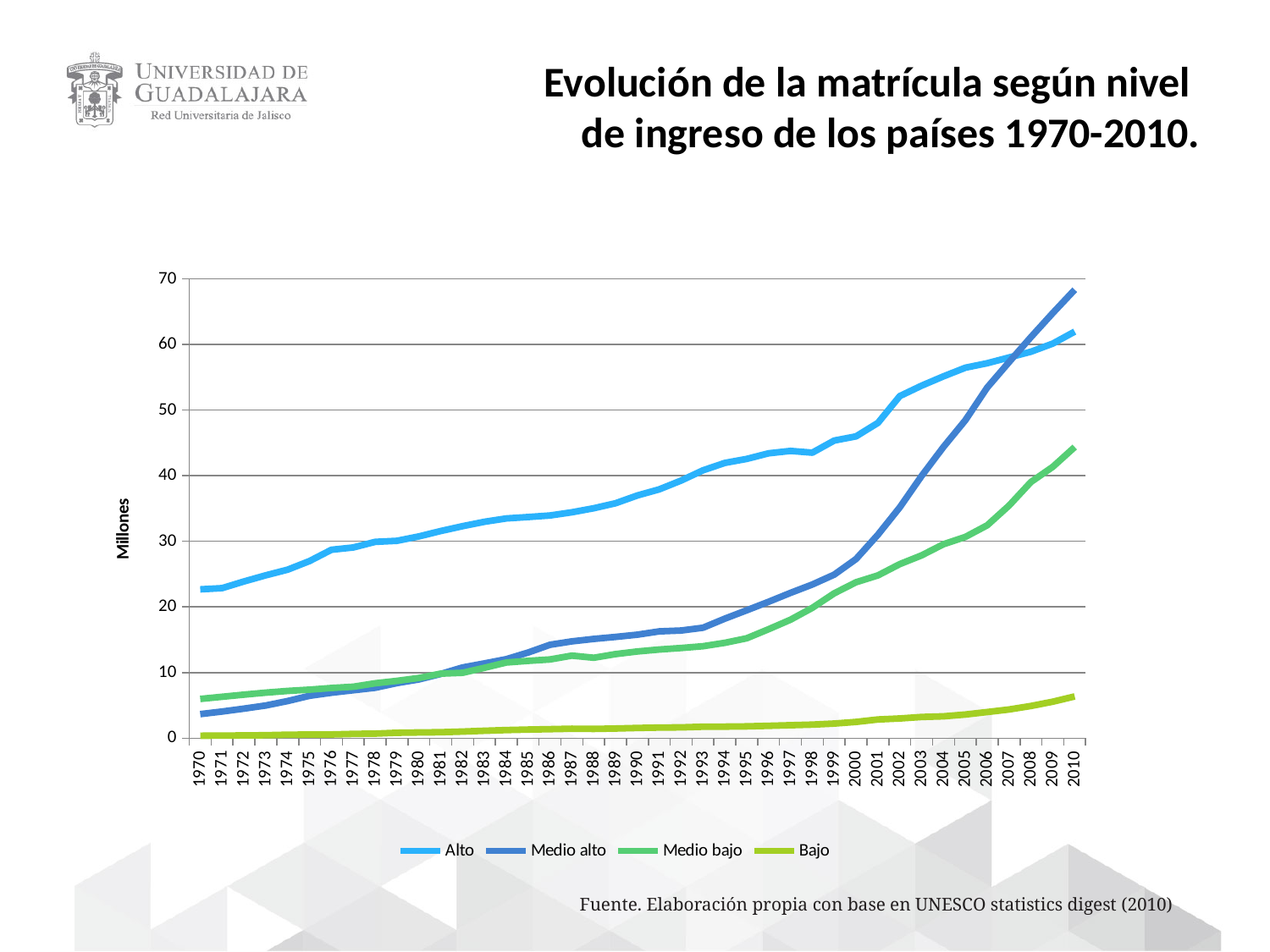
Is the value for Bajo in 2010 greater or less than 10? less How many years are shown along the x axis? 41 Which series has the highest value in 2010? Medio alto What is the label on the vertical axis? Millones Which series has the lowest value in 2010? Bajo Does the Medio alto series rise or fall from 1970 to 2010? rise What kind of chart is shown on the slide? line chart How many series does the legend list? 4 In 2000, which is larger: the value for Alto or the value for Medio alto? Alto Which series has the highest value in 1970? Alto Is the value for Medio alto in 2010 greater or less than 60? greater Is the value for Alto in 1970 greater or less than 20? greater